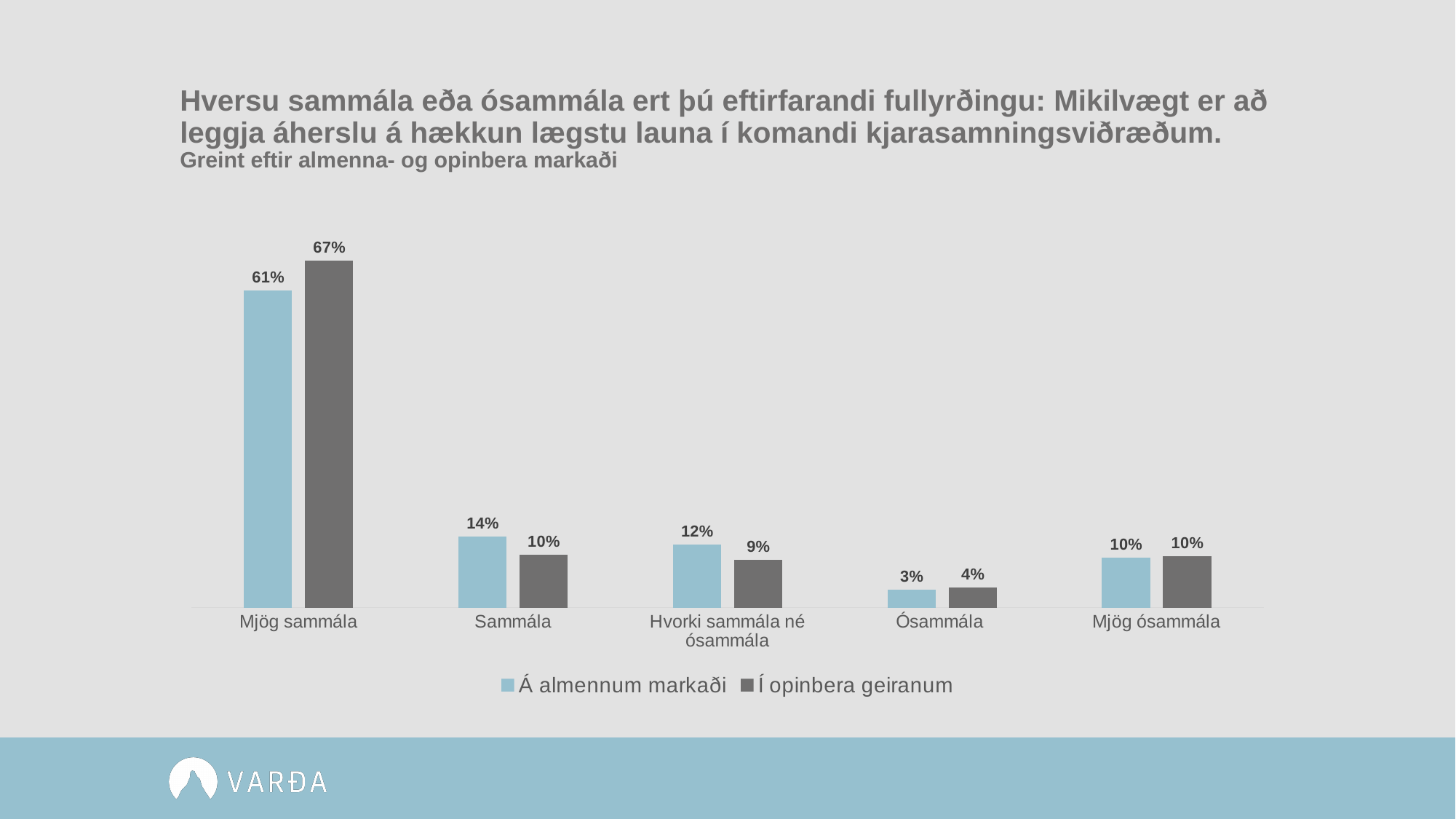
What is the value for 'Á almennum markaði' in the 'Sammála' category? 14% What is the value for 'Í opinbera geiranum' in the 'Mjög sammála' category? 67% Which category has the lowest value for 'Á almennum markaði'? Ósammála What is the value for 'Í opinbera geiranum' in the 'Hvorki sammála né ósammála' category? 9% How many series does the legend list? 2 What is the value for 'Í opinbera geiranum' in the 'Ósammála' category? 4% What is the value for 'Á almennum markaði' in the 'Mjög sammála' category? 61% What kind of chart is shown on the slide? Bar chart In the 'Sammála' category, which series has the larger value, 'Á almennum markaði' or 'Í opinbera geiranum'? Á almennum markaði What is the difference between the 'Í opinbera geiranum' and 'Á almennum markaði' values in the 'Mjög sammála' category? 6% How many categories are shown on the x axis? 5 Which category has the highest value for 'Í opinbera geiranum'? Mjög sammála